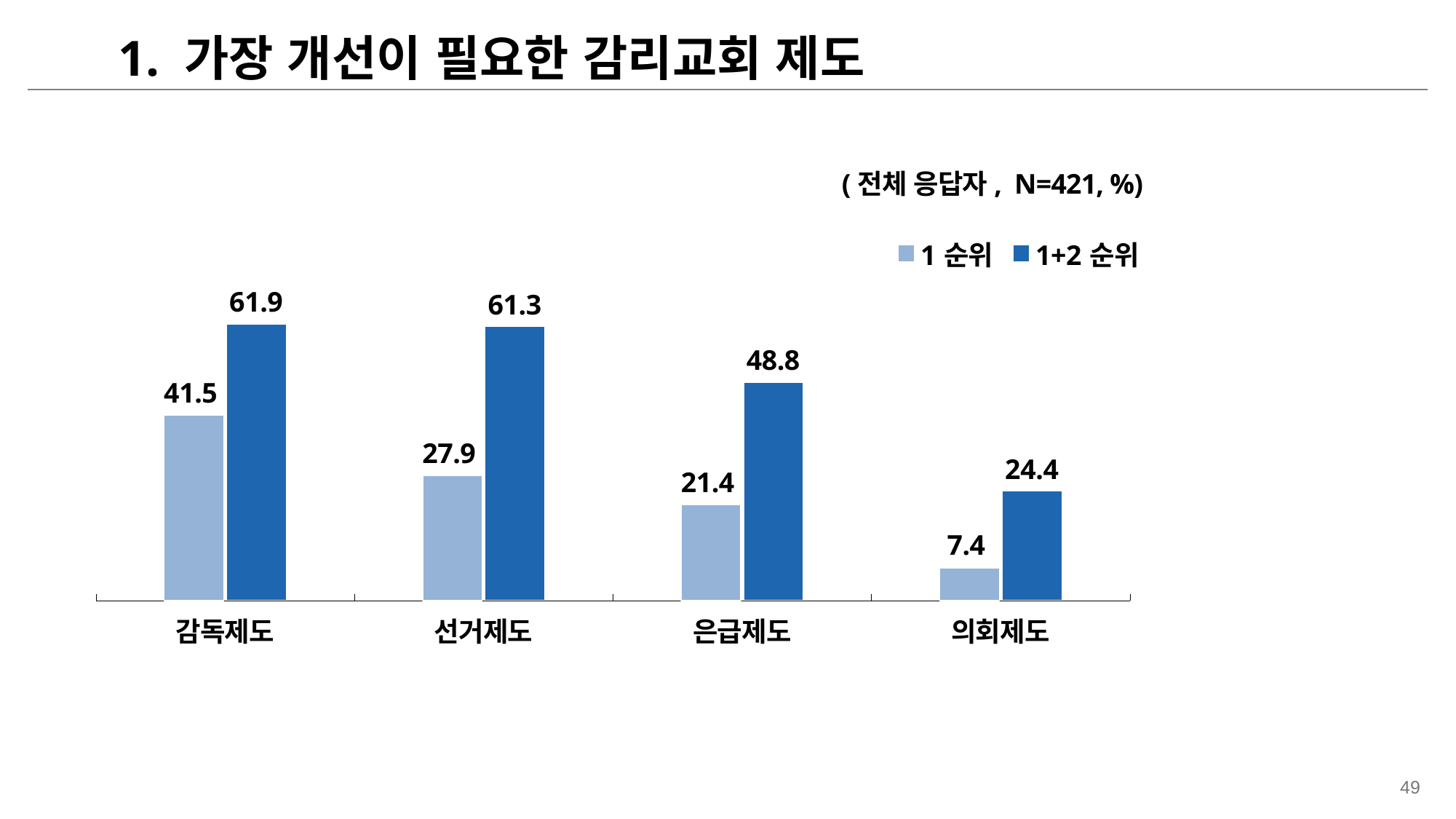
How many categories are shown on the x axis? 4 What is the 1 순위 value for 의회제도? 7.4 What is the difference between the 1+2 순위 and 1 순위 values for 선거제도? 33.4 What is the sample size (N) stated on the slide? 421 What is the 1 순위 value for 감독제도? 41.5 Which is larger, the 1 순위 value for 감독제도 or the 1 순위 value for 선거제도? 감독제도 What is the 1+2 순위 value for 은급제도? 48.8 Do the 1+2 순위 values rise or fall from 감독제도 to 의회제도 along the x axis? fall What kind of chart is shown on the slide? bar chart Which category has the highest 1+2 순위 value? 감독제도 How many series does the legend list? 2 Which category has the lowest 1 순위 value? 의회제도